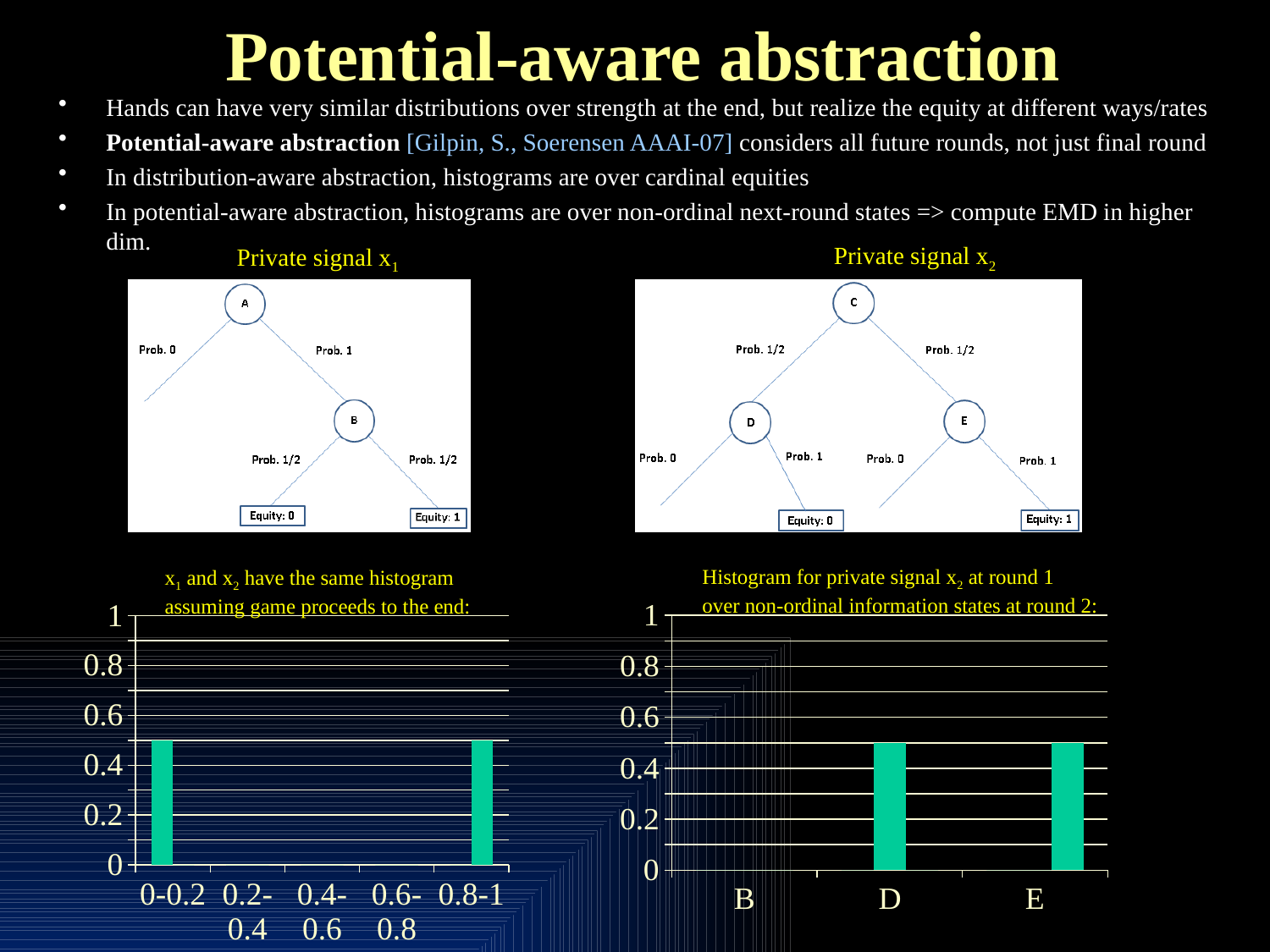
In the left chart (x1 and x2 have the same histogram), is the value for 0.4-0.6 greater or less than 0.2? less In the right chart (Histogram for private signal x2 at round 1), is the value for D greater or less than 0.4? greater In the right chart (Histogram for private signal x2 at round 1), which category has the lowest value? B How many categories are shown on the x axis of the right chart (Histogram for private signal x2 at round 1)? 3 How many categories are shown on the x axis of the left chart (x1 and x2 have the same histogram)? 5 In the left chart (x1 and x2 have the same histogram), which is larger, the value for 0-0.2 or the value for 0.2-0.4? 0-0.2 In the right chart (Histogram for private signal x2 at round 1), which is larger, the value for B or the value for E? E What kind of chart is the left chart (x1 and x2 have the same histogram)? bar chart What kind of chart is the right chart (Histogram for private signal x2 at round 1)? bar chart In the right chart (Histogram for private signal x2 at round 1), is the value for E greater or less than 0.6? less